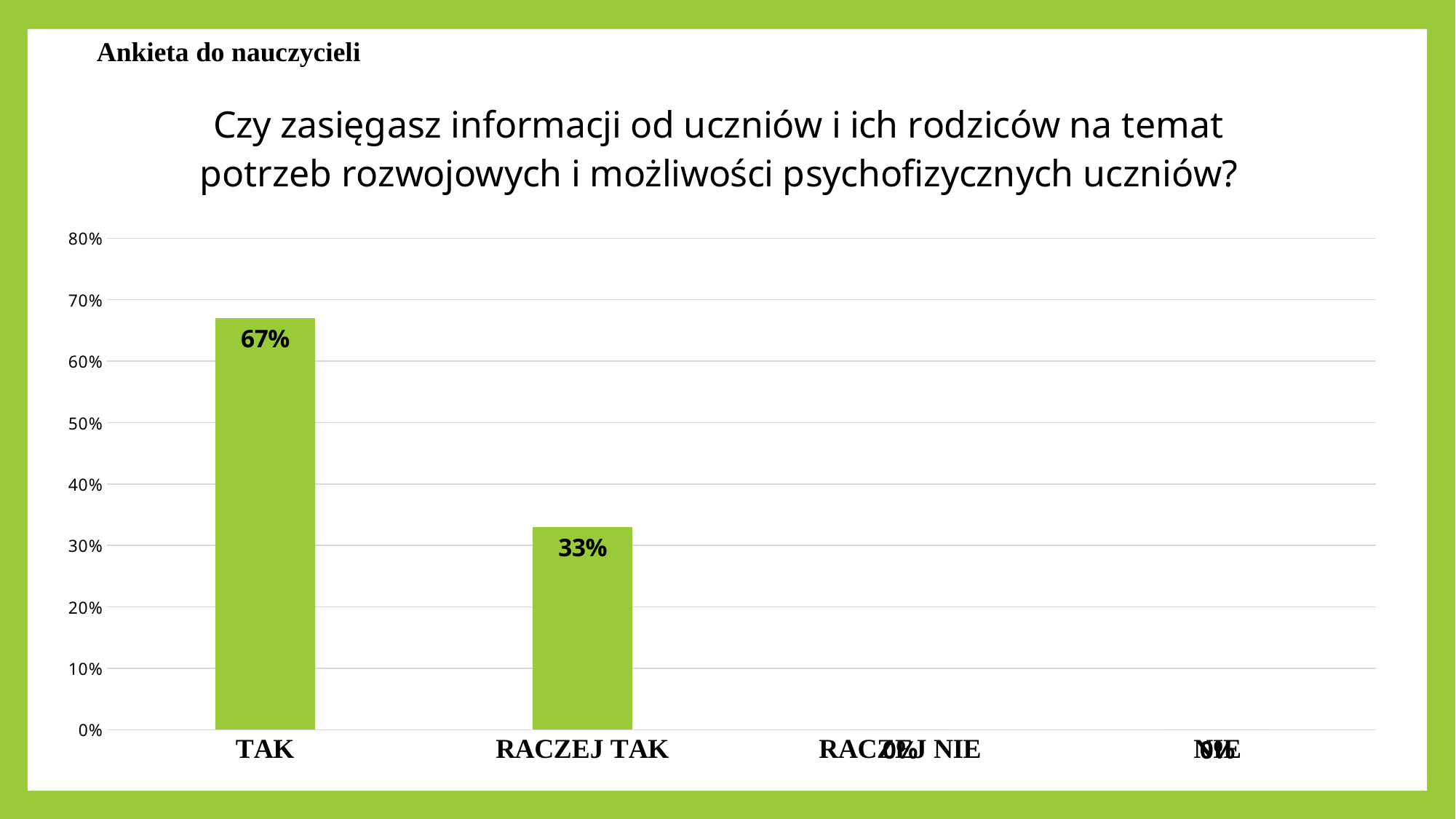
What is the value for RACZEJ TAK? 33% Is the value for TAK greater or less than 60%? greater What is the highest value shown on the y axis? 80% What kind of chart is shown on the slide? bar chart What is the value for TAK? 67% What is the difference between the values for TAK and RACZEJ TAK? 34% What is the value for RACZEJ NIE? 0% Which category has the highest value? TAK Is the value for RACZEJ TAK greater or less than 40%? less How many categories are shown on the x axis? 4 Which is larger, the value for TAK or the value for RACZEJ TAK? TAK What is the value for NIE? 0%